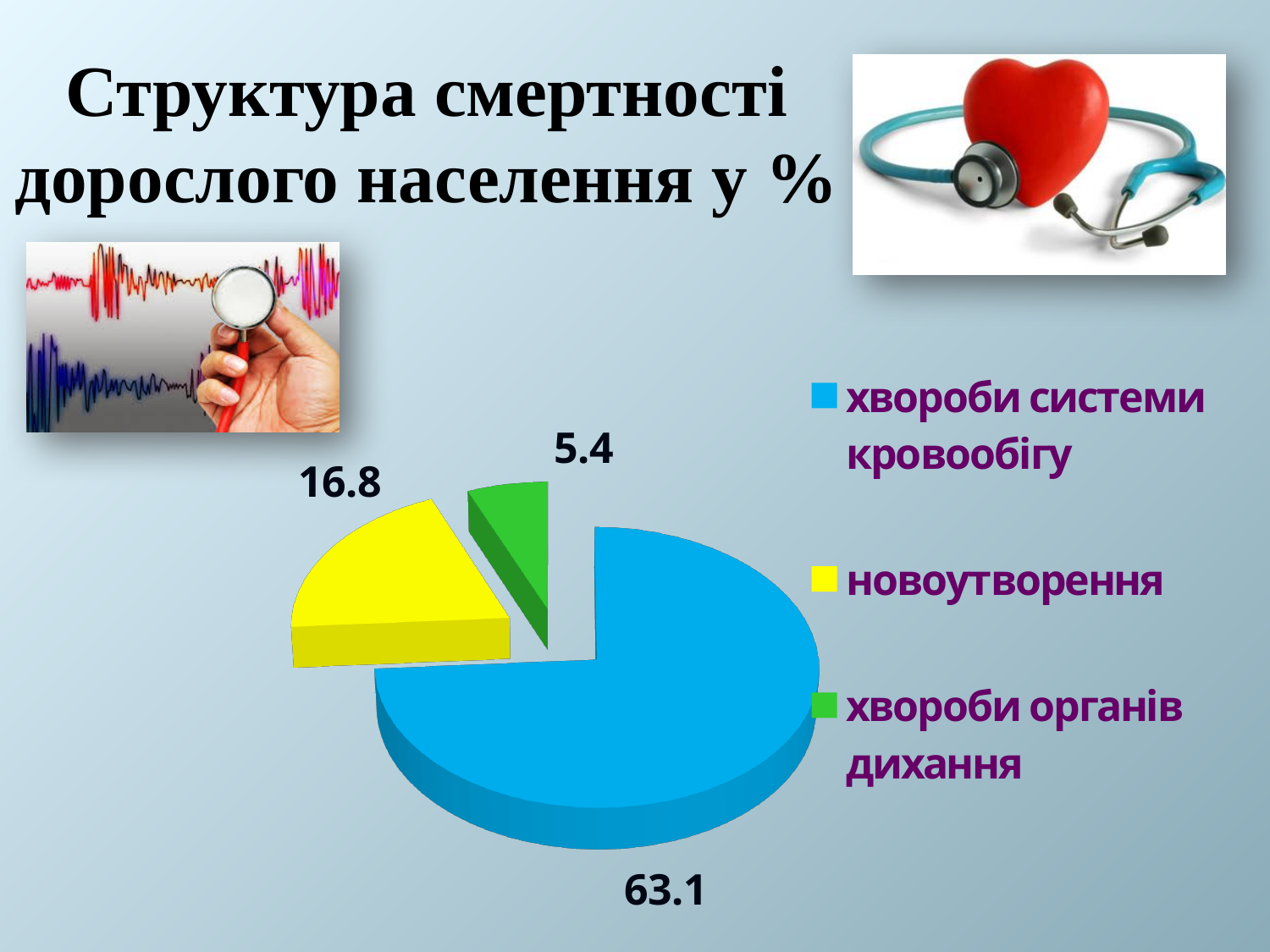
What is the difference between the values for хвороби системи кровообігу and новоутворення? 46.3 What is the difference between the values for новоутворення and хвороби органів дихання? 11.4 What is the value shown for новоутворення? 16.8 How many categories does the pie chart show? 3 What is the title of the slide containing the chart? Структура смертності дорослого населення у % What type of chart is shown on the slide? pie chart Which category has the largest slice of the pie? хвороби системи кровообігу Which is larger, the value for новоутворення or the value for хвороби органів дихання? новоутворення What colour is the slice for новоутворення? yellow What is the value shown for хвороби системи кровообігу? 63.1 What is the value shown for хвороби органів дихання? 5.4 Which category has the smallest slice of the pie? хвороби органів дихання